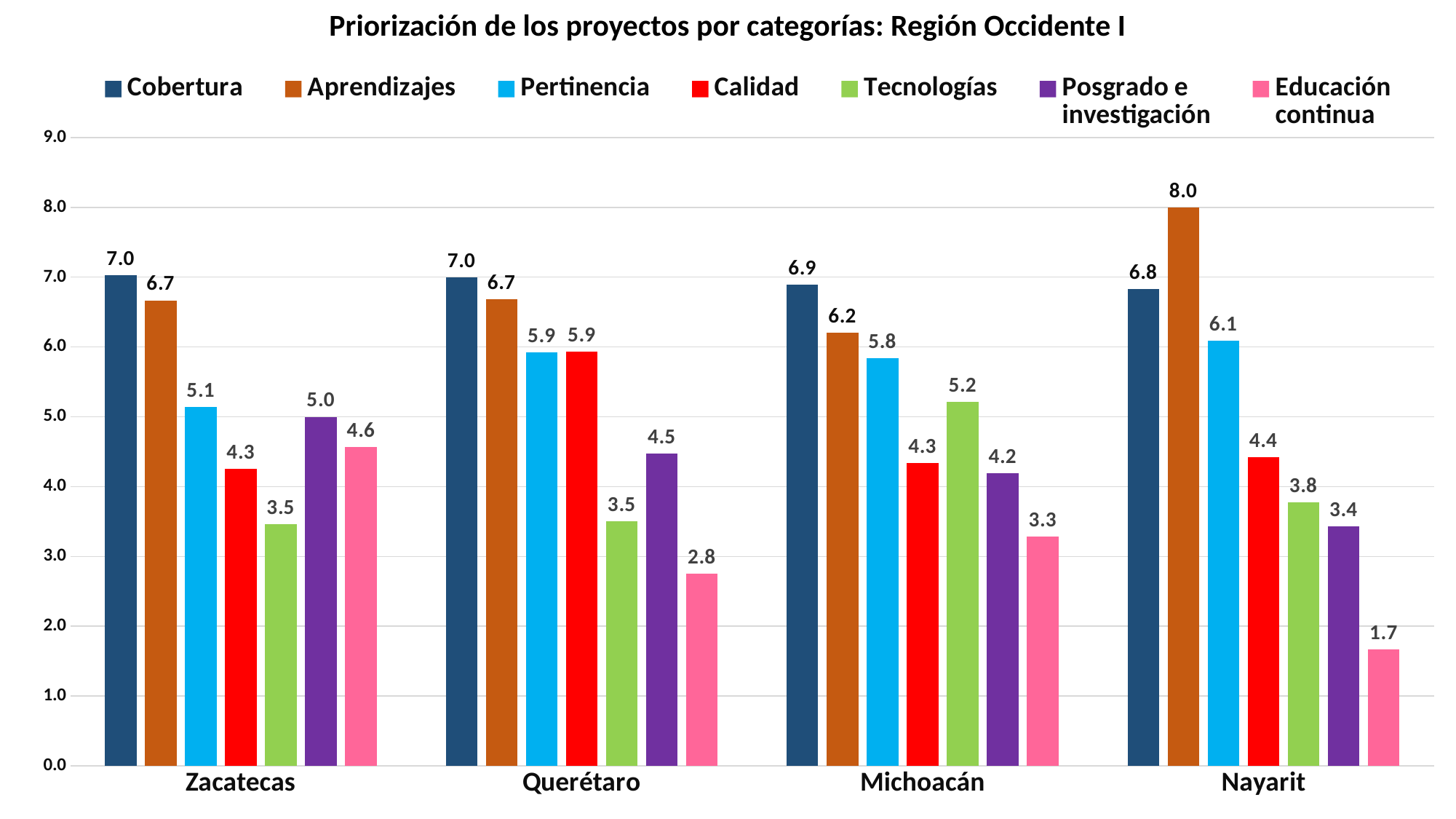
How many categories are shown on the x axis? 4 How many series does the legend list? 7 What is the value for Educación continua in Querétaro? 2.8 What kind of chart is shown? Bar chart Which is larger in Zacatecas: Pertinencia or Posgrado e investigación? Pertinencia What is the difference between Aprendizajes and Cobertura in Nayarit? 1.2 Which category has the lowest Educación continua value? Nayarit Which category has the highest Cobertura value? Zacatecas and Querétaro (7.0) What is the value for Tecnologías in Michoacán? 5.2 Is the value for Calidad in Querétaro greater or less than 5.0? greater What is the title of the chart? Priorización de los proyectos por categorías: Región Occidente I What is the value for Aprendizajes in Nayarit? 8.0